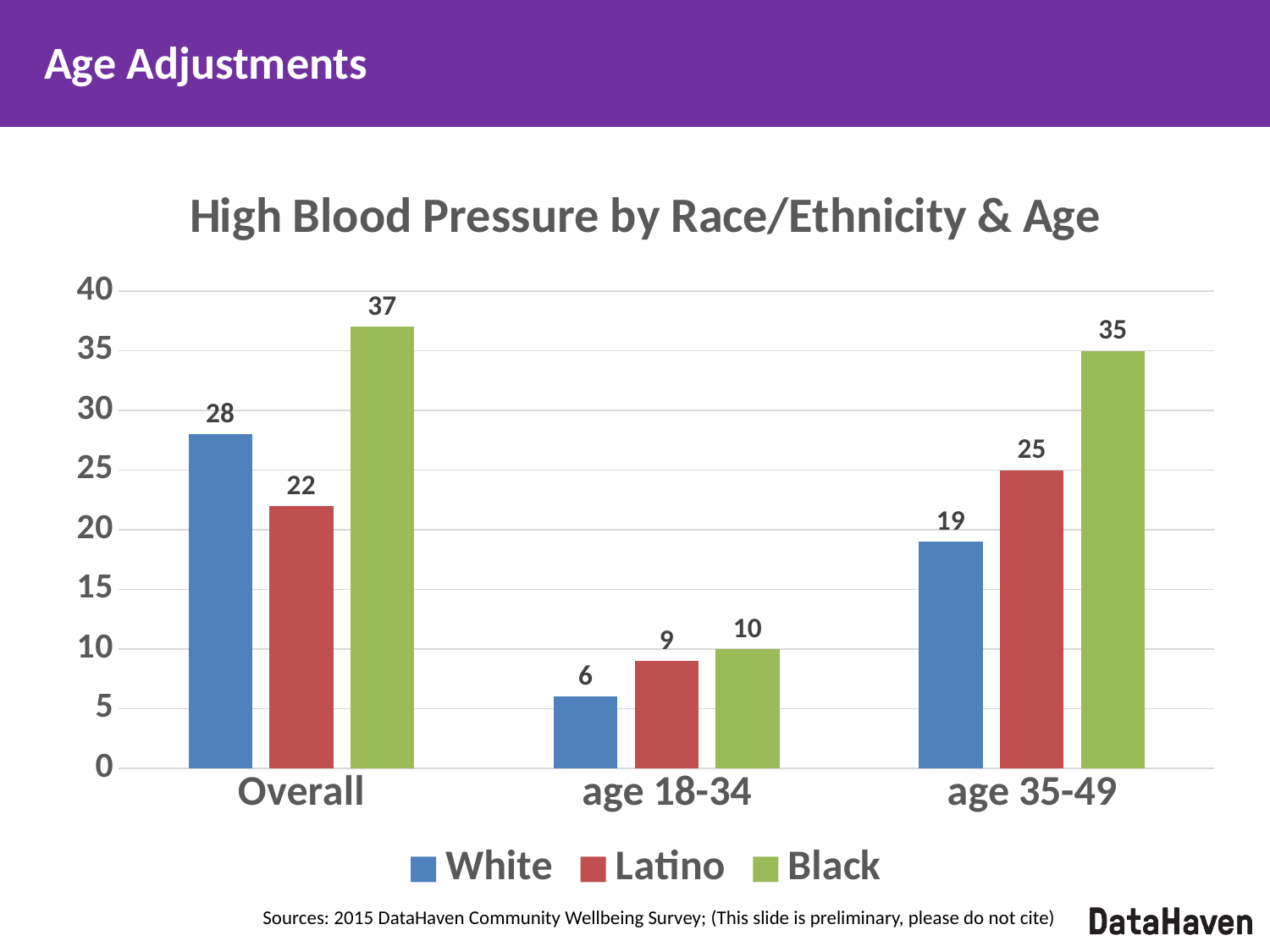
What kind of chart is shown on the slide? bar chart How many series does the legend list? 3 What is the value for Latino in the age 35-49 category? 25 Which is larger: the Latino value for age 18-34 or the Latino value for age 35-49? age 35-49 Which colour represents the Black series in the chart? green What is the value for White in the age 18-34 category? 6 What is the value for Black in the Overall category? 37 Which series has the highest value in the age 35-49 category? Black Which series has the lowest value in the Overall category? Latino What is the title of the chart? High Blood Pressure by Race/Ethnicity & Age How many categories are shown on the x axis? 3 What is the difference between the Black and White values in the Overall category? 9